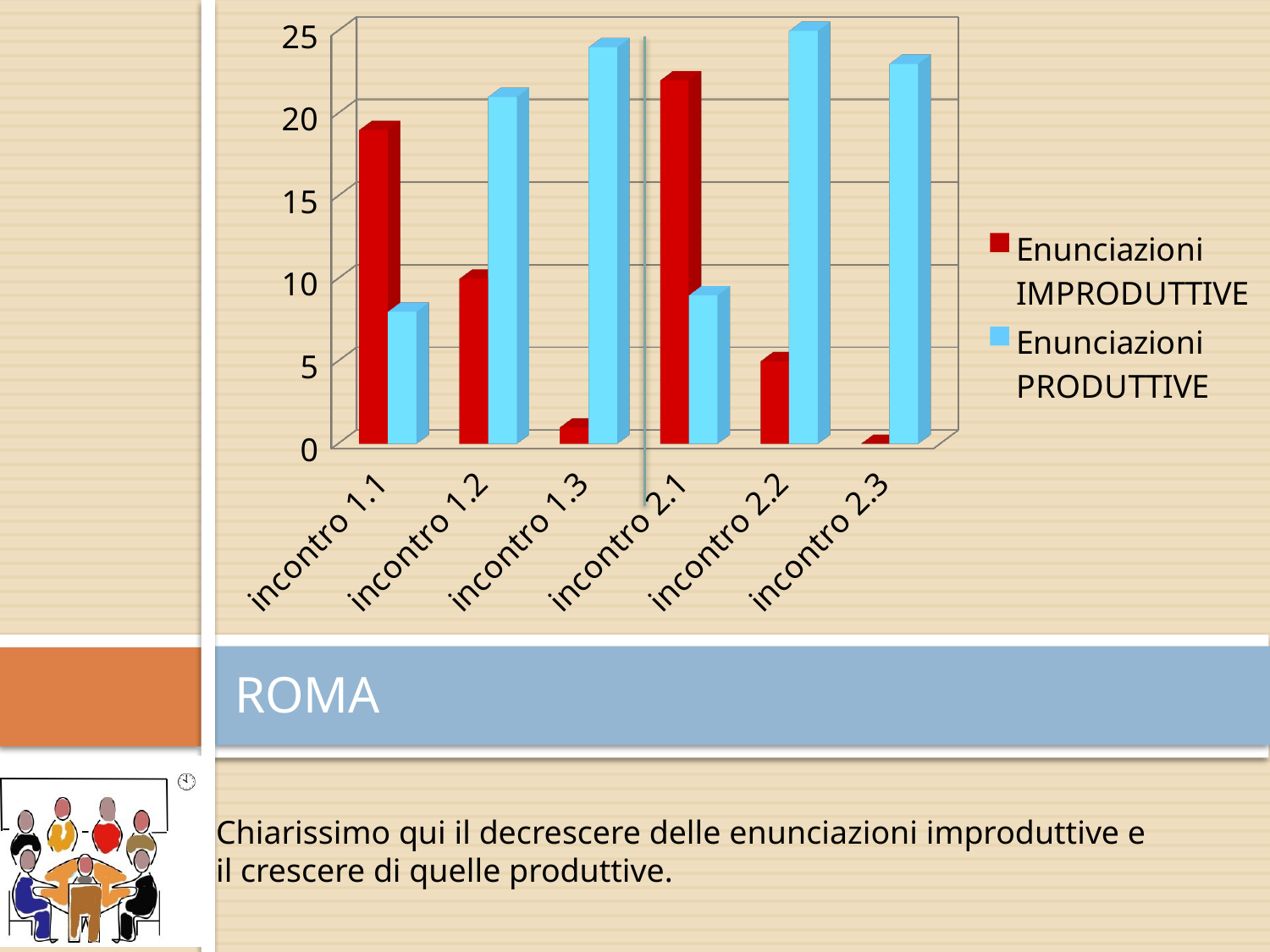
Is the value for Enunciazioni IMPRODUTTIVE at incontro 1.1 greater or less than 15? greater Is the value for Enunciazioni PRODUTTIVE at incontro 2.2 greater or less than 20? greater Is the value for Enunciazioni IMPRODUTTIVE at incontro 1.3 greater or less than 5? less How many categories are shown on the x axis? 6 What colour represents Enunciazioni PRODUTTIVE in the chart? light blue At incontro 1.1, which series has the larger value, Enunciazioni IMPRODUTTIVE or Enunciazioni PRODUTTIVE? Enunciazioni IMPRODUTTIVE How many series does the legend list? 2 Which category has the highest value for Enunciazioni IMPRODUTTIVE? incontro 2.1 At incontro 2.3, which series has the larger value, Enunciazioni IMPRODUTTIVE or Enunciazioni PRODUTTIVE? Enunciazioni PRODUTTIVE Which category has the lowest value for Enunciazioni IMPRODUTTIVE? incontro 2.3 What kind of chart is shown on the slide? bar chart